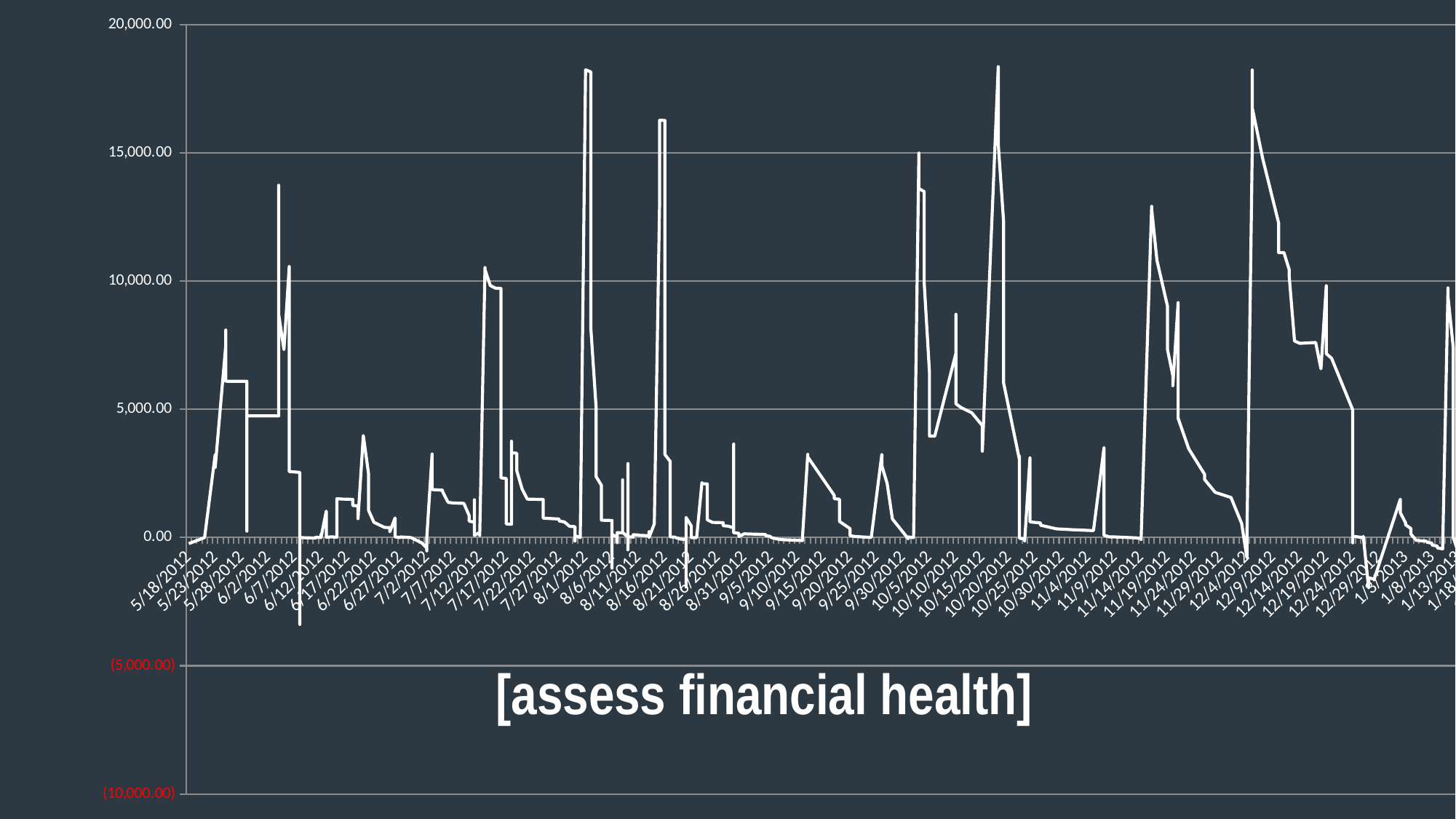
Is the highest peak of the line greater or less than 15,000.00? greater What kind of chart is shown on the slide? line chart What is the lowest value shown on the vertical axis? (10,000.00) What is the first date label on the horizontal axis? 5/18/2012 Is the value for 11/4/2012 greater or less than 5,000.00? less What is the highest value shown on the vertical axis? 20,000.00 Is the value for 9/5/2012 greater or less than 5,000.00? less